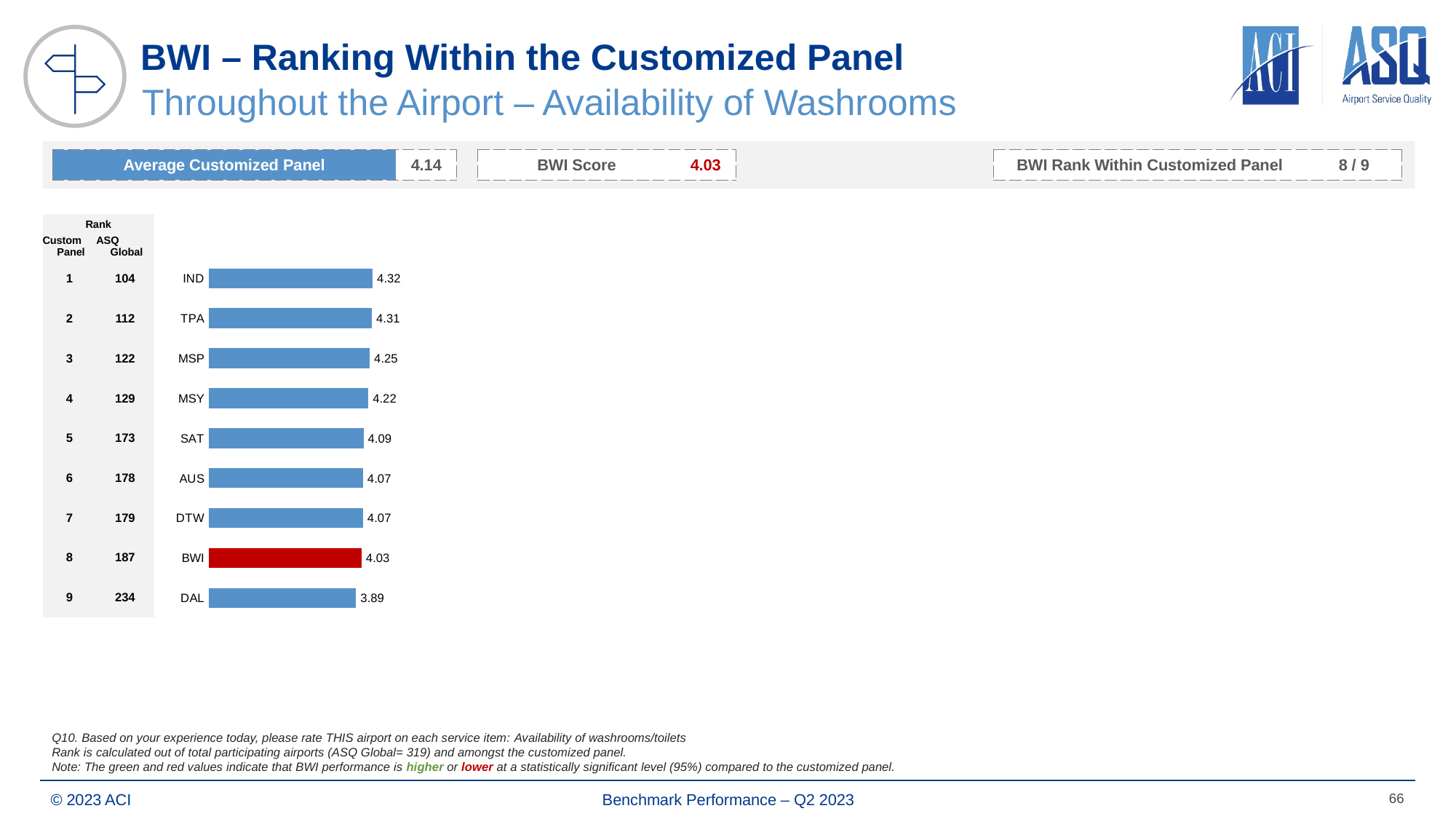
Which airport has the highest value? IND Which airport has the lowest value? DAL What is the value for BWI? 4.03 What is the difference between the values for IND and BWI? 0.29 What kind of chart is shown on the slide? Bar chart What is the value for DAL? 3.89 What is the difference between the values for MSY and DAL? 0.33 How many airports are shown in the chart? 9 What is the value for MSP? 4.25 What is the value for IND? 4.32 Which bar is coloured red in the chart? BWI Which is larger, the value for TPA or the value for SAT? TPA